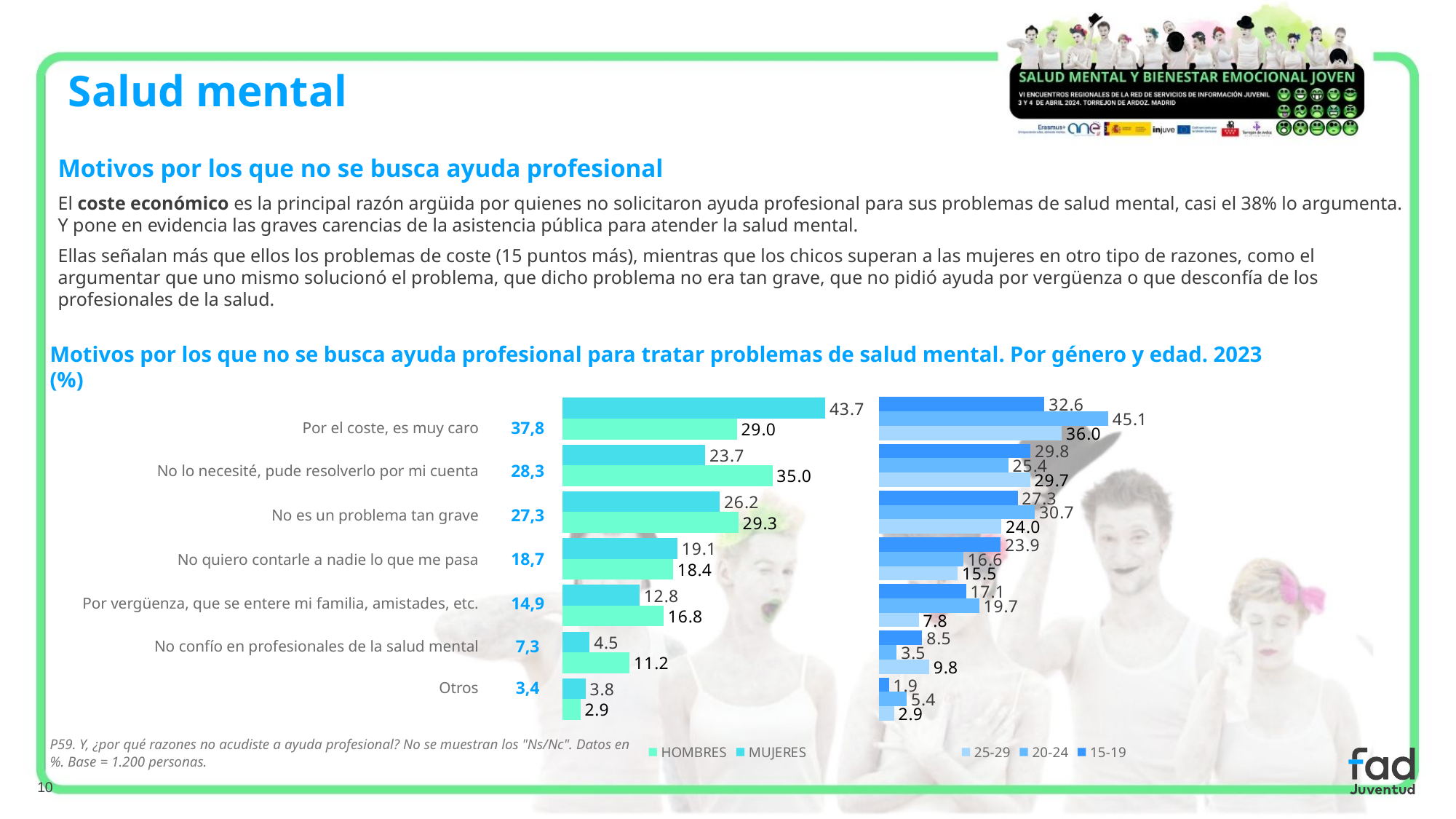
In the right chart (by age), which age group has the lowest value for 'Otros'? 15-19 What is the overall total shown in blue for 'No confío en profesionales de la salud mental'? 7,3 What type of chart is used on this slide? Bar chart How many reason categories are shown in the charts? 7 In the right chart (by age), what is the value for the 25-29 group for 'Por vergüenza, que se entere mi familia, amistades, etc.'? 7.8 How many series does the legend of the right chart (by age) list? 3 In the left chart (by gender), what is the difference between MUJERES and HOMBRES for 'Por el coste, es muy caro'? 14.7 In the right chart (by age), what is the value for the 20-24 group for 'Por el coste, es muy caro'? 45.1 In the left chart (by gender), what is the value for MUJERES for 'Por el coste, es muy caro'? 43.7 In the left chart (by gender), which is larger for 'No confío en profesionales de la salud mental', HOMBRES or MUJERES? HOMBRES In the left chart (by gender), what is the value for HOMBRES for 'No lo necesité, pude resolverlo por mi cuenta'? 35.0 In the right chart (by age), which age group has the highest value for 'No quiero contarle a nadie lo que me pasa'? 15-19